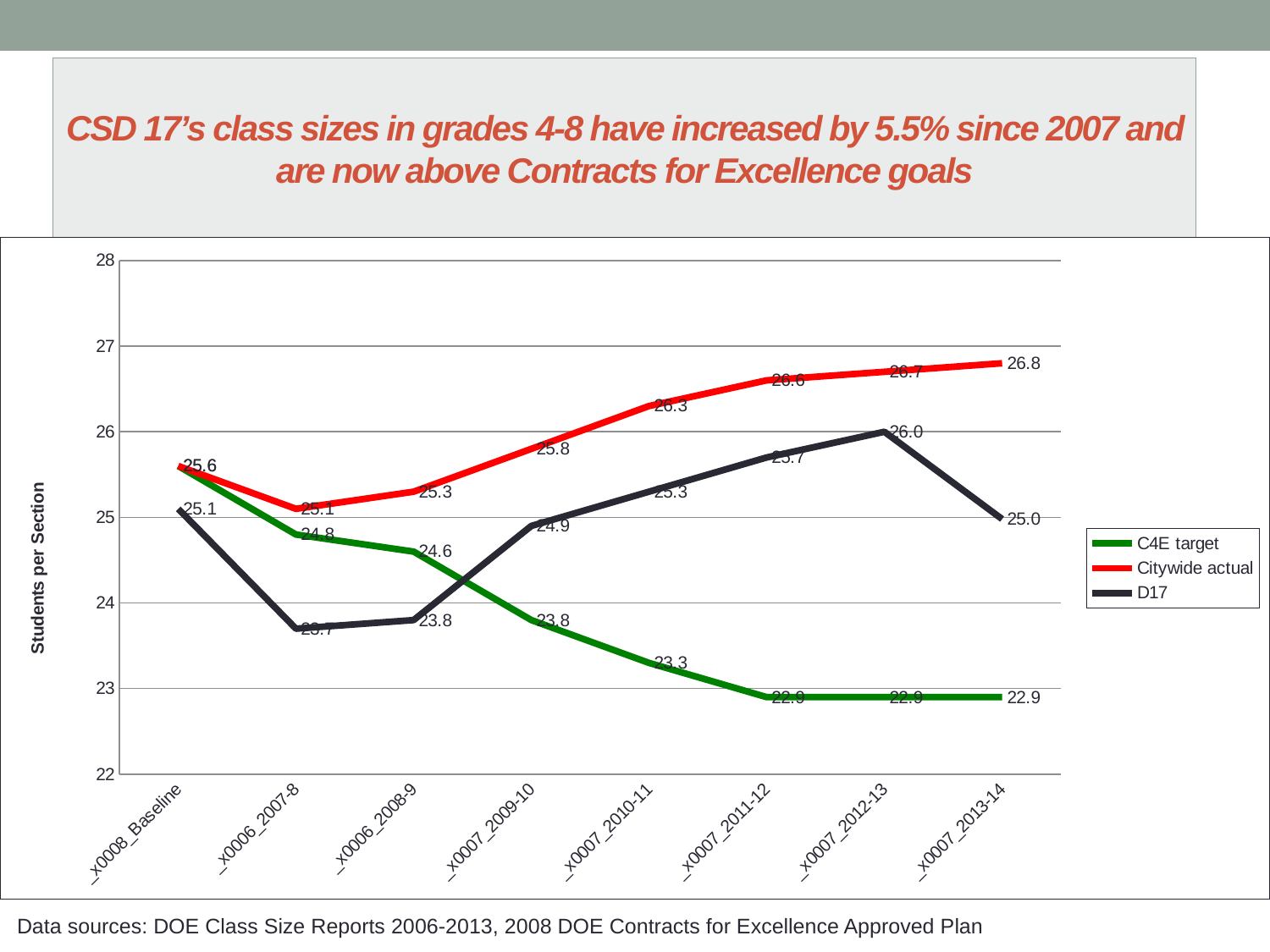
In 2013-14, which is larger: the D17 value or the C4E target value? D17 What is the D17 value for 2012-13? 26.0 What is the Citywide actual value for 2013-14? 26.8 What is the D17 value for 2013-14? 25.0 What is the C4E target value for 2008-9? 24.6 What is the C4E target value for 2013-14? 22.9 What is the difference between the Citywide actual and the C4E target values in 2013-14? 3.9 In which year does the D17 series reach its highest value? 2012-13 How many points are plotted along the x axis for each series? 8 What kind of chart is shown on the slide? line chart How many series does the legend list? 3 Does the Citywide actual series rise or fall from 2009-10 to 2013-14? rise